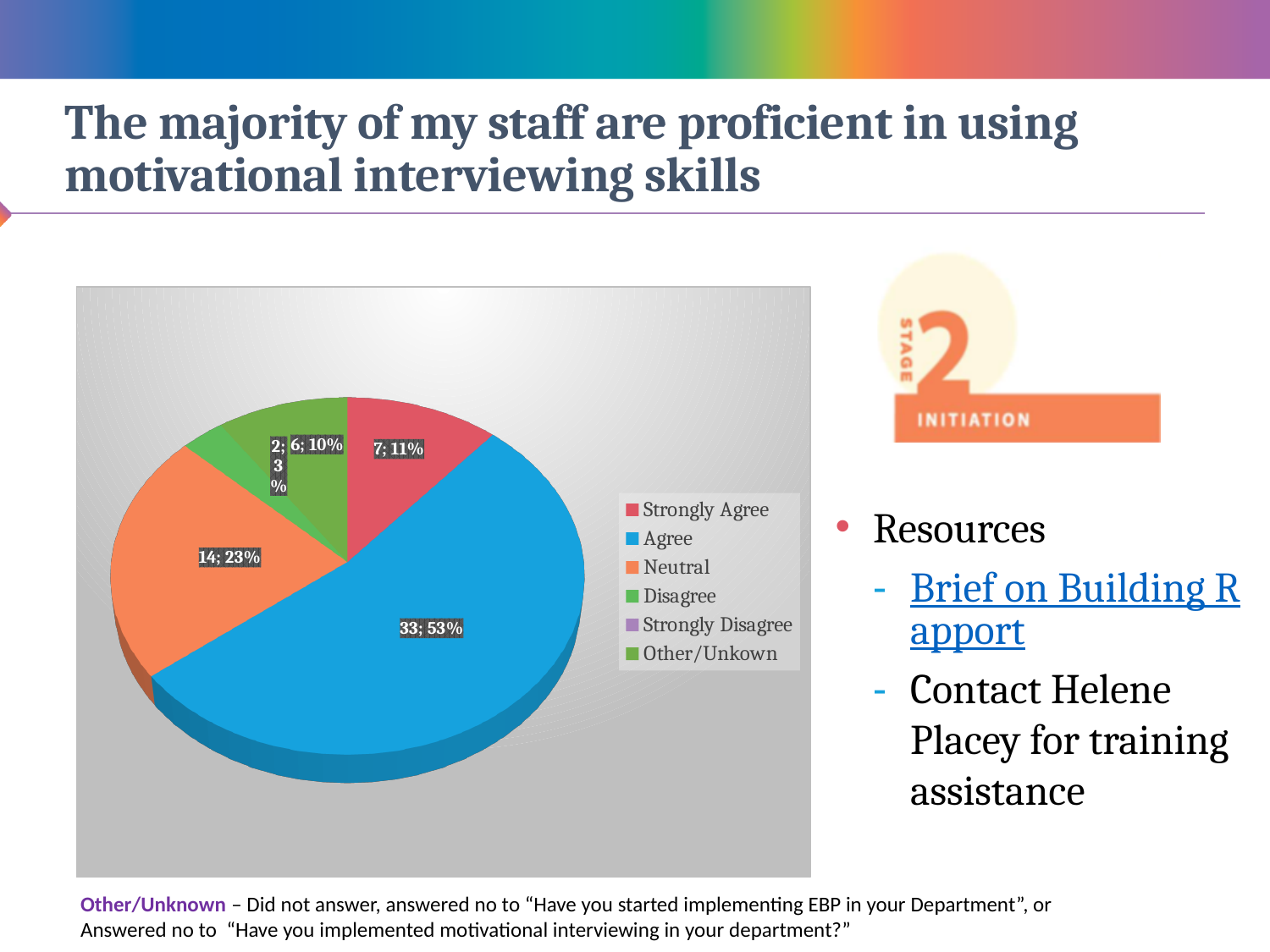
What share of the pie does the Strongly Agree slice represent? 11% Which has a larger count in the pie chart, Strongly Agree or Other/Unknown? Strongly Agree What share of the pie does the Agree slice represent? 53% What is the difference between the Agree count and the Neutral count in the pie chart? 19 What kind of chart is shown on the slide? pie chart What colour is the Agree slice in the pie chart? blue How many respondents chose Agree in the pie chart? 33 Which category has the largest slice in the pie chart? Agree What share of the pie does the Neutral slice represent? 23% How many respondents chose Neutral in the pie chart? 14 Which category has the smallest visible slice in the pie chart? Disagree How many categories does the legend of the pie chart list? 6